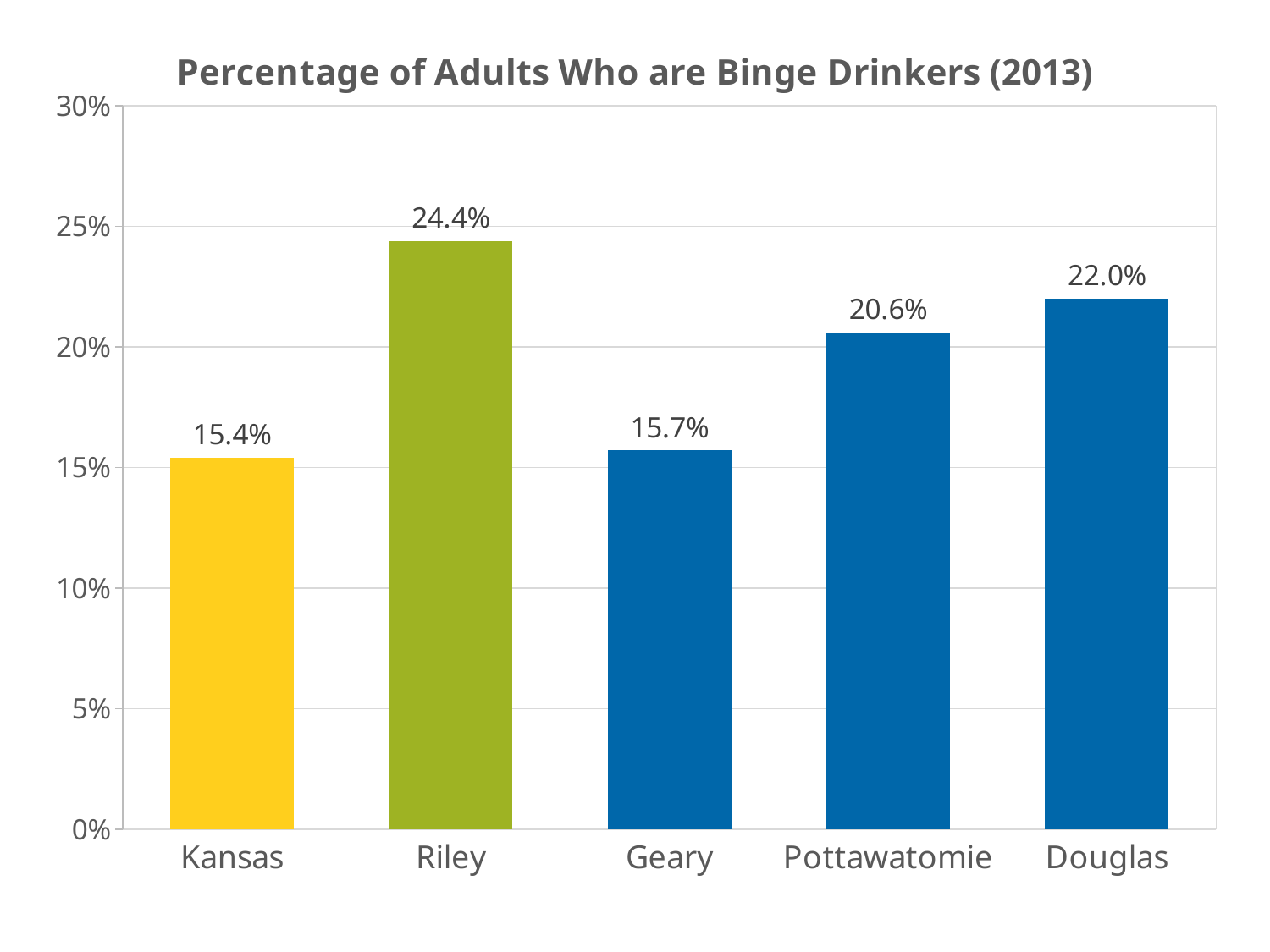
Which has a higher value, Douglas or Pottawatomie? Douglas How many categories are shown on the chart? 5 What is the percentage of adults who are binge drinkers in Riley? 24.4% Is the value for Geary greater or less than 20%? less Which category has the highest percentage of binge drinkers? Riley What is the difference between the values for Douglas and Geary? 6.3% What is the value shown for Kansas? 15.4% What is the title of the chart? Percentage of Adults Who are Binge Drinkers (2013) What is the value shown for Pottawatomie? 20.6% What kind of chart is shown on the slide? Bar chart What is the difference between the values for Riley and Kansas? 9.0% Which category has the lowest percentage of binge drinkers? Kansas